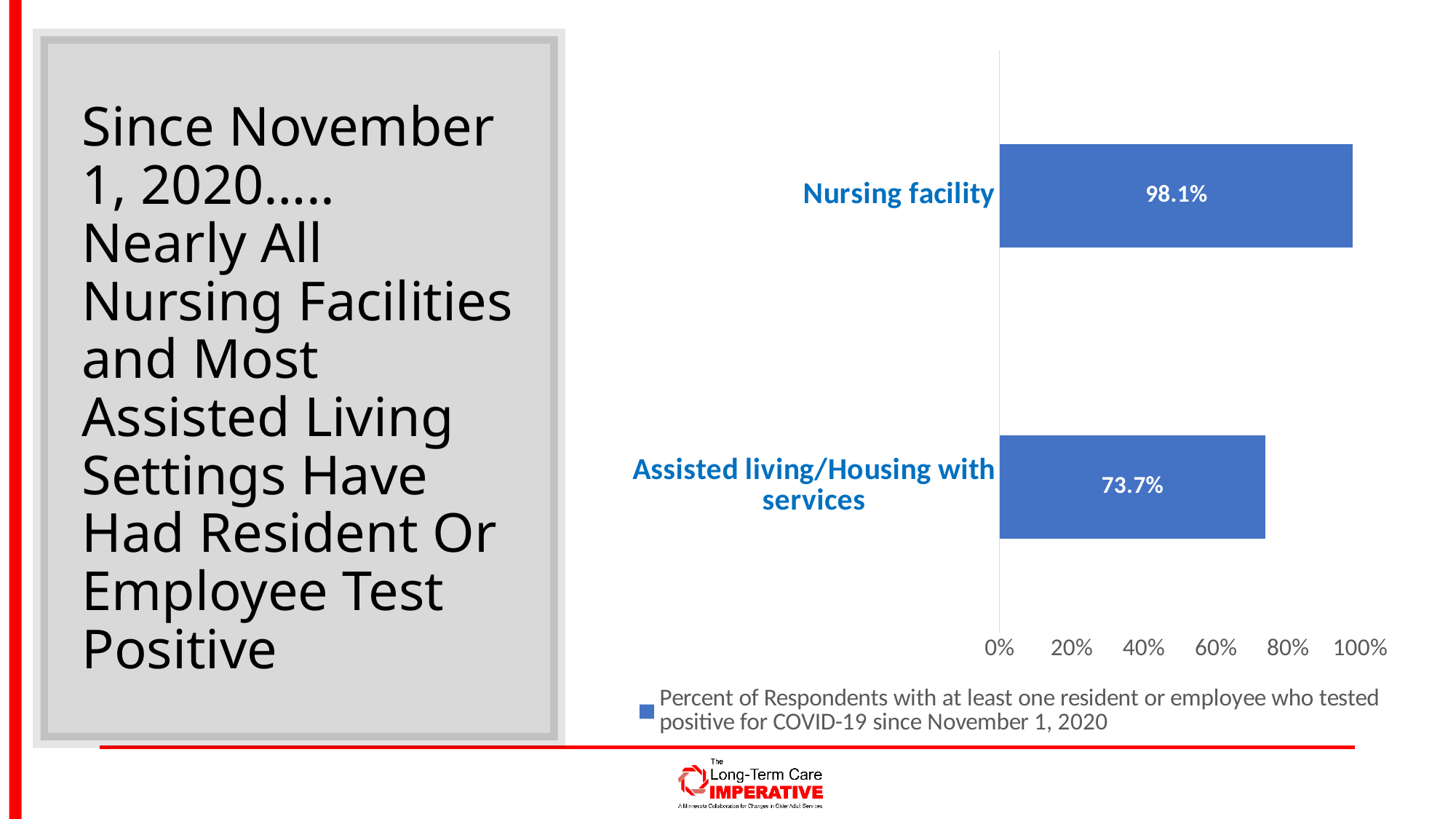
What is the legend entry for the series in the chart? Percent of Respondents with at least one resident or employee who tested positive for COVID-19 since November 1, 2020 What is the value for Nursing facility? 98.1% What is the value for Assisted living/Housing with services? 73.7% Is the value for Assisted living/Housing with services greater or less than 80%? less How many categories are shown in the chart? 2 Which is larger, the value for Nursing facility or the value for Assisted living/Housing with services? Nursing facility Which category has the highest value? Nursing facility What is the difference between the values for Nursing facility and Assisted living/Housing with services? 24.4% How many series does the legend list? 1 Which category has the lowest value? Assisted living/Housing with services Is the value for Nursing facility greater or less than 80%? greater What kind of chart is shown on the slide? Bar chart